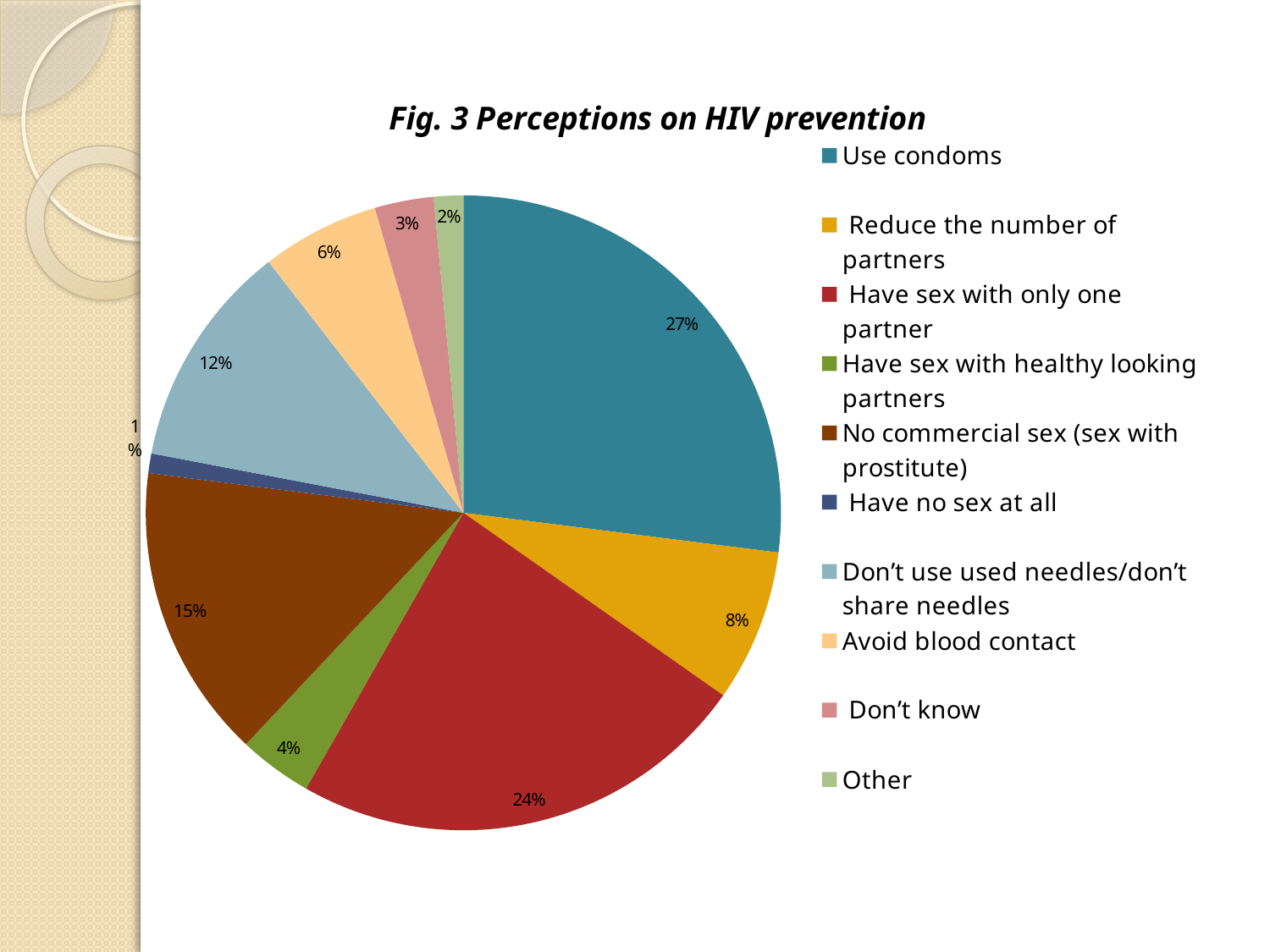
What is the value for "No commercial sex (sex with prostitute)"? 15% How many categories does the legend list? 10 What share of the pie does "Use condoms" represent? 27% Which category has the smallest share of the pie? Have no sex at all Which category has the largest share of the pie? Use condoms What percentage is shown for "Don't use used needles/don't share needles"? 12% What kind of chart is shown on the slide? Pie chart What percentage is shown for "Have sex with only one partner"? 24% What is the value for "Avoid blood contact"? 6% What is the difference between the shares for "Use condoms" and "Have sex with only one partner"? 3% Which is larger: the share for "Reduce the number of partners" or the share for "Avoid blood contact"? Reduce the number of partners What is the title of the chart? Fig. 3 Perceptions on HIV prevention